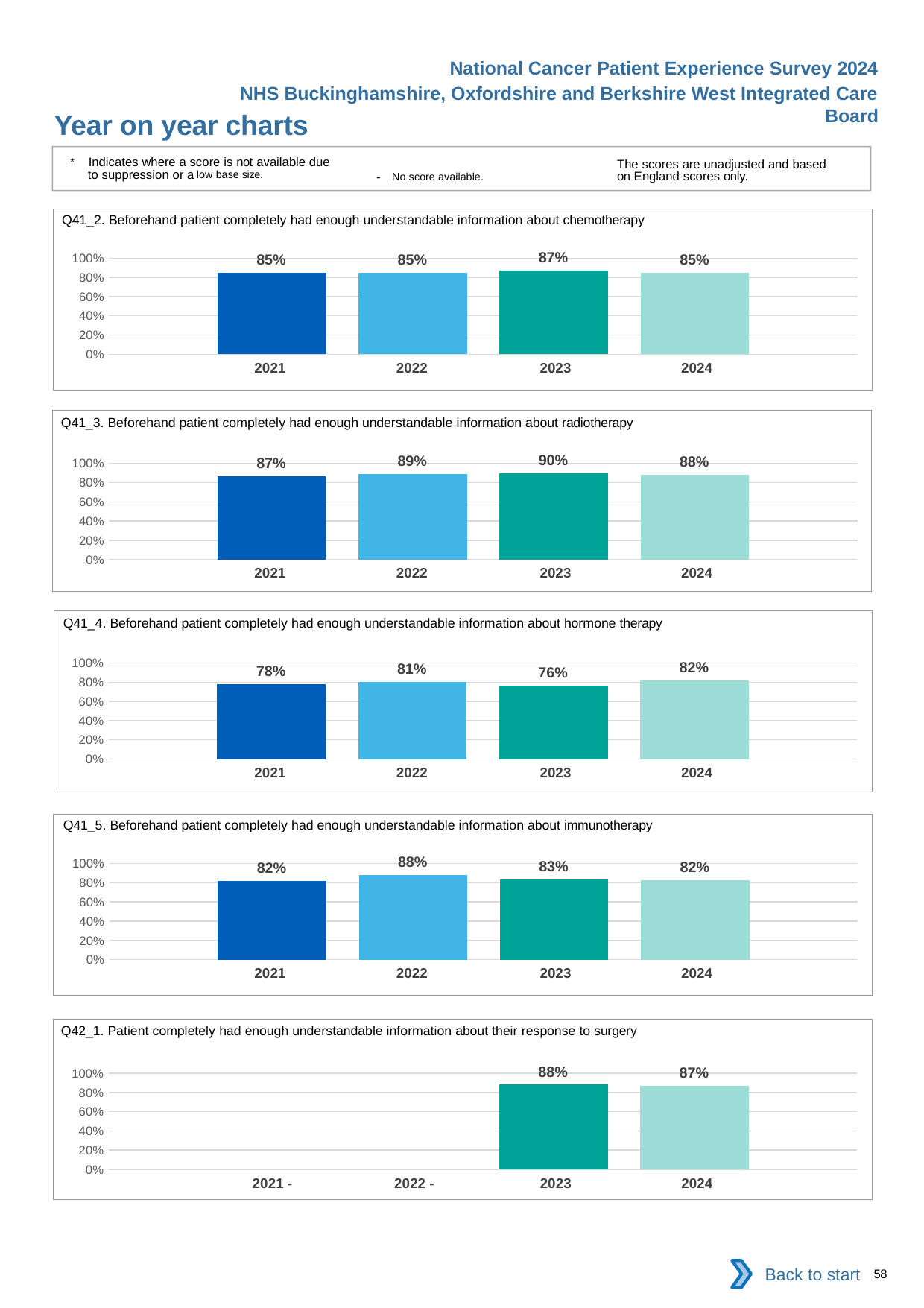
What kind of chart is the Q41_3 chart (radiotherapy)? Bar chart In the Q41_3 chart (radiotherapy), what is the difference between the 2023 and 2021 values? 3% In the Q41_3 chart (radiotherapy), which year has the highest value? 2023 In the Q41_4 chart (hormone therapy), which is larger, the value for 2022 or the value for 2023? 2022 In the Q41_2 chart (chemotherapy), how many years are shown on the x axis? 4 How many charts are shown on the slide? 5 In the Q41_2 chart (chemotherapy), what is the value for 2023? 87% In the Q41_5 chart (immunotherapy), what is the difference between the 2022 and 2021 values? 6% In the Q41_5 chart (immunotherapy), is the value for 2022 greater or less than 80%? greater In the Q42_1 chart (response to surgery), how many years have a bar plotted? 2 In the Q41_4 chart (hormone therapy), which year has the lowest value? 2023 In the Q42_1 chart (response to surgery), what is the value for 2024? 87%